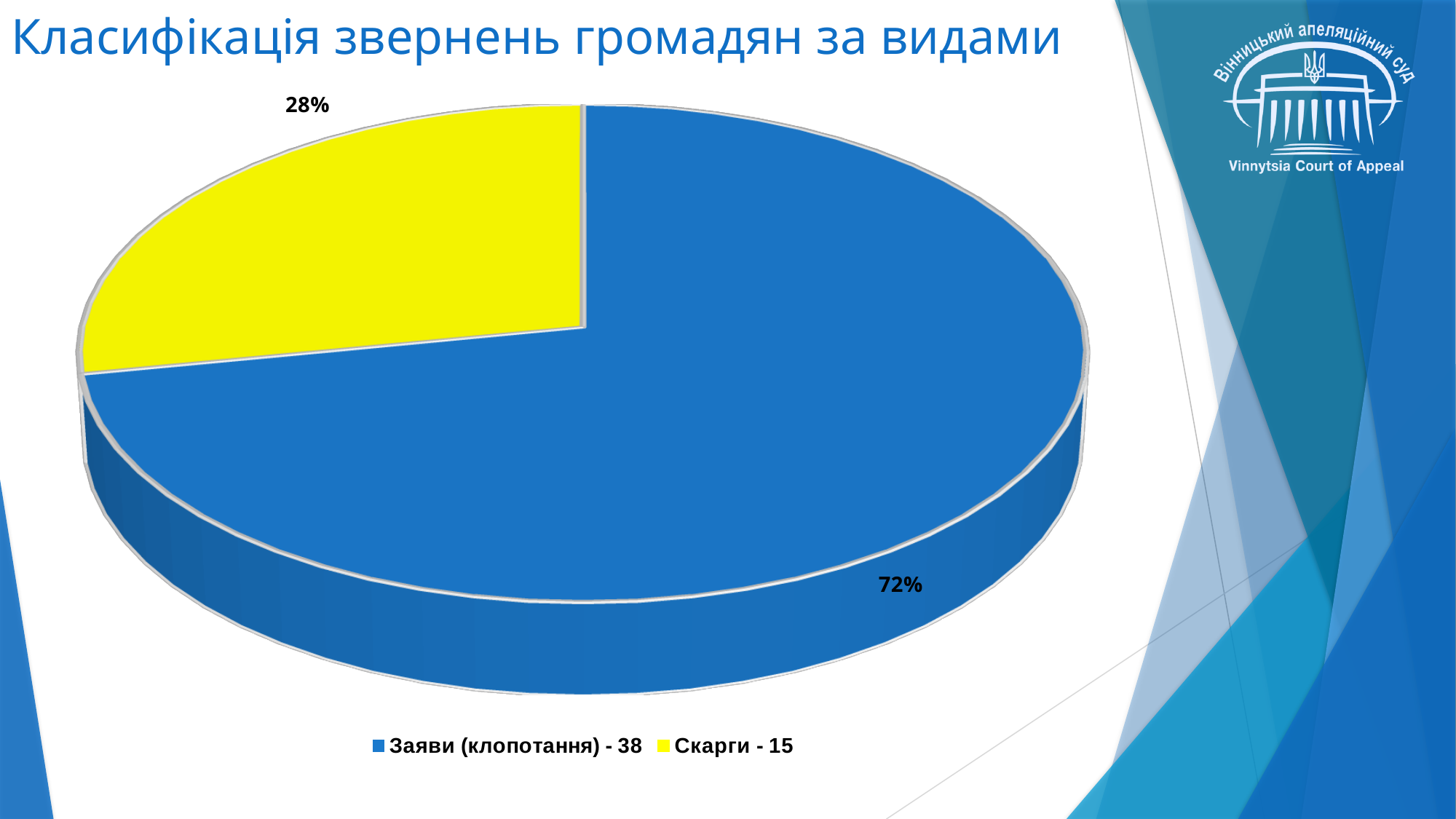
What percentage share does the slice for Скарги - 15 have? 28% How many categories does the pie chart show? 2 What percentage share does the slice for Заяви (клопотання) - 38 have? 72% What is the title of the slide? Класифікація звернень громадян за видами Which slice is larger: Заяви (клопотання) or Скарги? Заяви (клопотання) Which category has the smallest slice of the pie? Скарги - 15 How many entries does the legend list? 2 What is the difference in percentage points between the Заяви (клопотання) slice and the Скарги slice? 44 Which category has the largest slice of the pie? Заяви (клопотання) - 38 What colour is the slice for Скарги - 15? yellow Is the share for Скарги greater or less than 50%? less What kind of chart is shown on the slide? pie chart